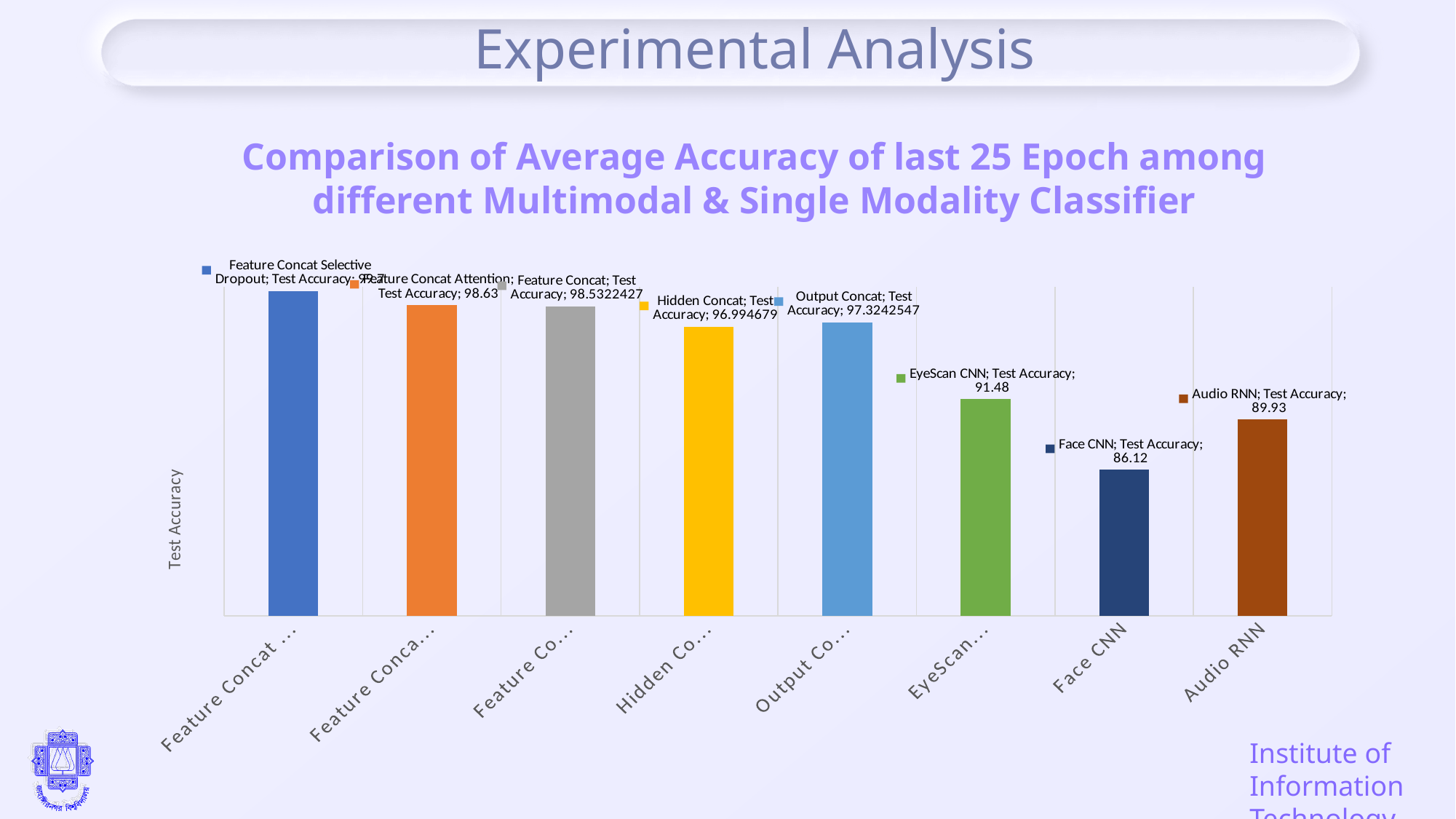
What is the test accuracy of Audio RNN? 89.93 What is the test accuracy of EyeScan CNN? 91.48 What is the test accuracy of Feature Concat Attention? 98.63 Which classifier has the highest test accuracy? Feature Concat Selective Dropout How many classifiers (bars) are plotted in the chart? 8 What is the difference in test accuracy between Audio RNN and Face CNN? 3.81 What is the test accuracy of Output Concat? 97.3242547 What is the test accuracy of Face CNN? 86.12 What is the label of the vertical axis? Test Accuracy Which classifier has the lowest test accuracy? Face CNN What type of chart is shown on the slide? bar chart Which has a higher test accuracy, Output Concat or Hidden Concat? Output Concat